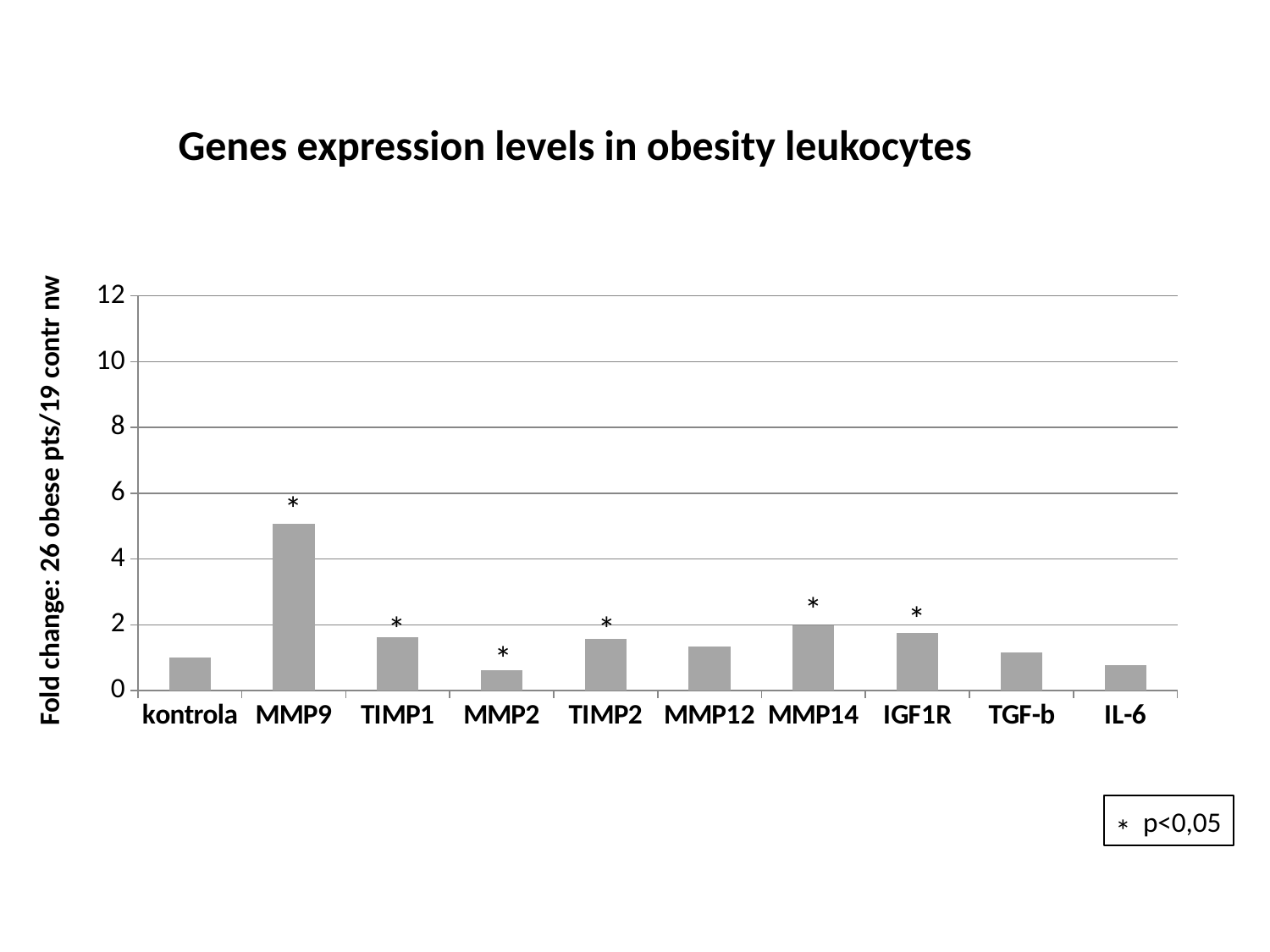
Which is larger, the value for MMP9 or the value for kontrola? MMP9 Is the value for MMP9 greater or less than 4? greater What is the title of the chart? Genes expression levels in obesity leukocytes Which category has the lowest fold change in the chart? MMP2 Is the value for IGF1R greater or less than 2? less What does the asterisk above some bars indicate, according to the slide? p<0,05 Is the value for MMP9 greater or less than 6? less Which is larger, the value for MMP14 or the value for MMP12? MMP14 How many genes/categories are shown on the x axis of the chart? 10 Which category has the highest fold change in the chart? MMP9 What kind of chart is shown on the slide? bar chart